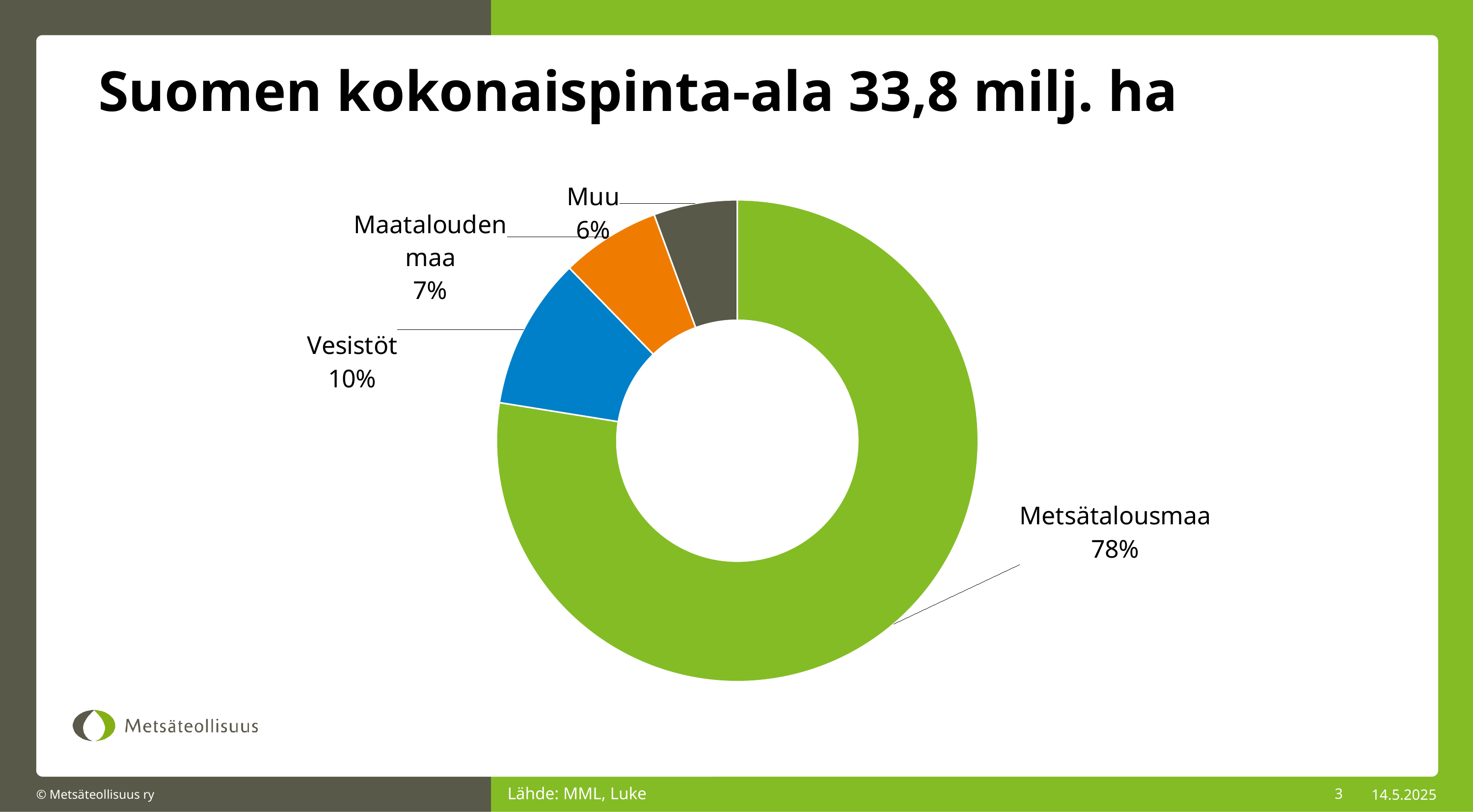
What is the difference in percentage points between Metsätalousmaa and Vesistöt? 68 Which is larger, the share for Vesistöt or the share for Muu? Vesistöt What share of the total area is Vesistöt? 10% What is the difference in percentage points between Vesistöt and Maatalouden maa? 3 What share of Finland's total area is Metsätalousmaa? 78% What kind of chart is shown on the slide? Doughnut (pie) chart What is the title of the slide? Suomen kokonaispinta-ala 33,8 milj. ha How many categories are shown in the chart? 4 Which category has the largest share of the total area? Metsätalousmaa What share of the total area is Muu? 6% What share of the total area is Maatalouden maa? 7% Which category has the smallest share of the total area? Muu